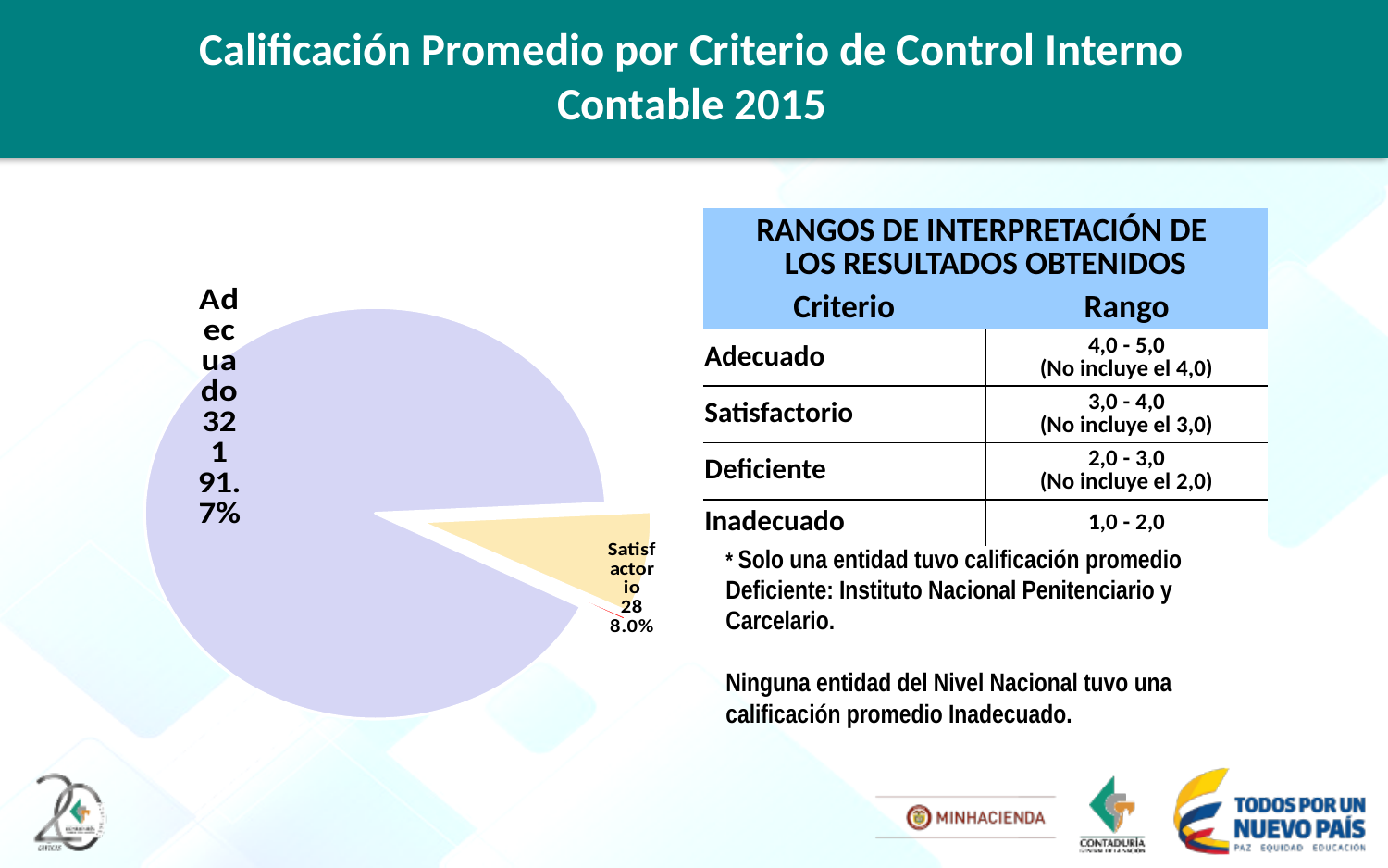
What colour is the Satisfactorio slice of the pie chart? yellow What is the value shown for the Satisfactorio slice of the pie chart? 28 Which is larger in the pie chart, Adecuado or Satisfactorio? Adecuado What percentage share of the pie does the Satisfactorio slice represent? 8.0% What is the difference between the Adecuado value and the Satisfactorio value in the pie chart? 293 What percentage share of the pie does the Adecuado slice represent? 91.7% What is the value shown for the Adecuado slice of the pie chart? 321 What is the total of the two values shown in the pie chart? 349 What kind of chart is shown on the slide? pie chart Which slice of the pie chart is the largest? Adecuado How many slices does the pie chart have? 3